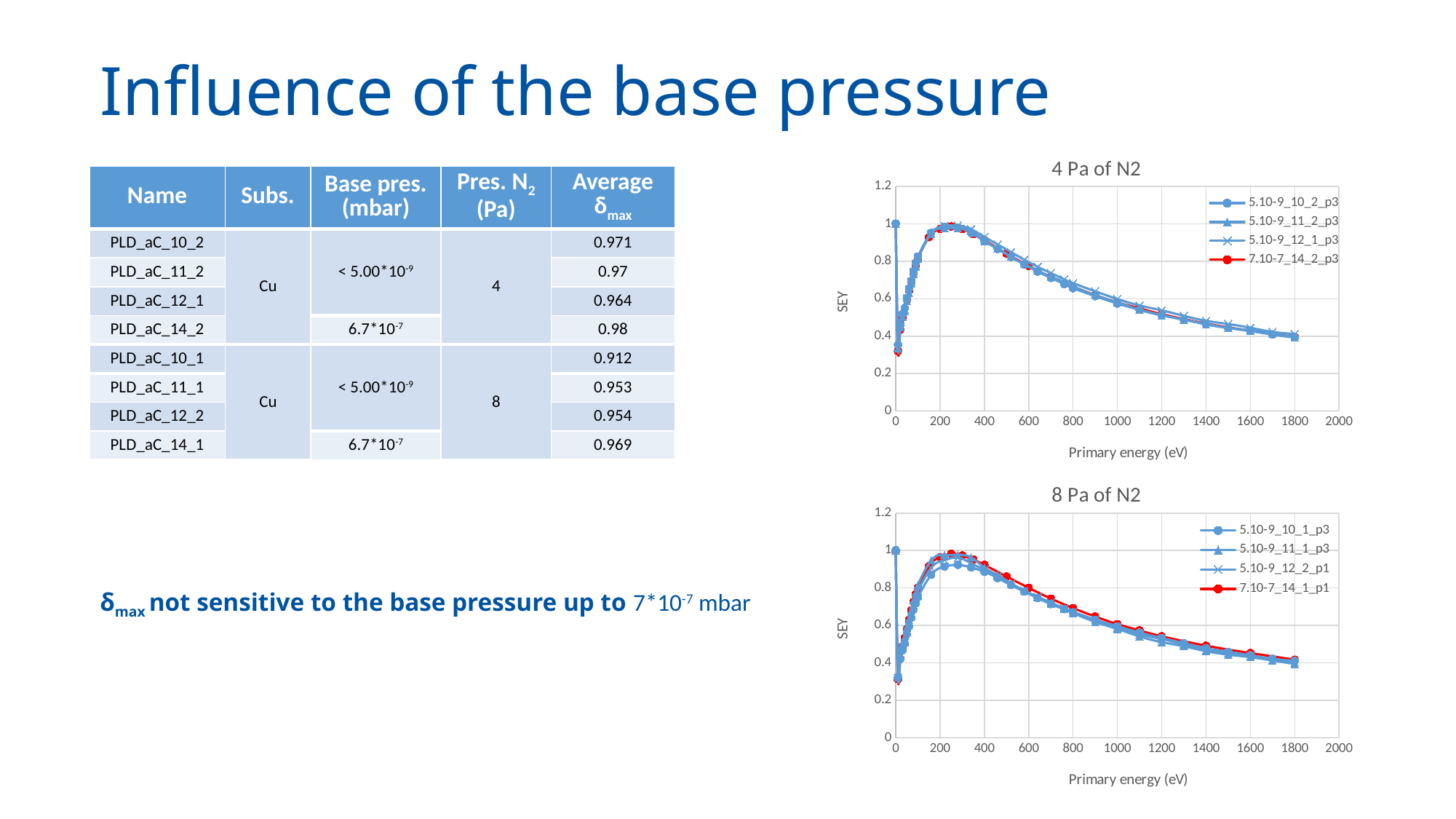
In the "8 Pa of N2" chart, do the SEY values rise or fall between 600 eV and 1800 eV? fall What is the title of the lower chart on the slide? 8 Pa of N2 In the "8 Pa of N2" chart, is the SEY value of the 7.10-7_14_1_p1 series at 200 eV greater or less than 0.8? greater In the "8 Pa of N2" chart, is the SEY value of the 5.10-9_10_1_p3 series at 1800 eV greater or less than 0.6? less What is the x-axis label of the "4 Pa of N2" chart? Primary energy (eV) In the "8 Pa of N2" chart, is the SEY value of the 7.10-7_14_1_p1 series at 1000 eV greater or less than 0.8? less How many series does the legend of the "4 Pa of N2" chart list? 4 In the "4 Pa of N2" chart, do the SEY values rise or fall between 400 eV and 1800 eV? fall What kind of chart is the "4 Pa of N2" chart? line chart How many series does the legend of the "8 Pa of N2" chart list? 4